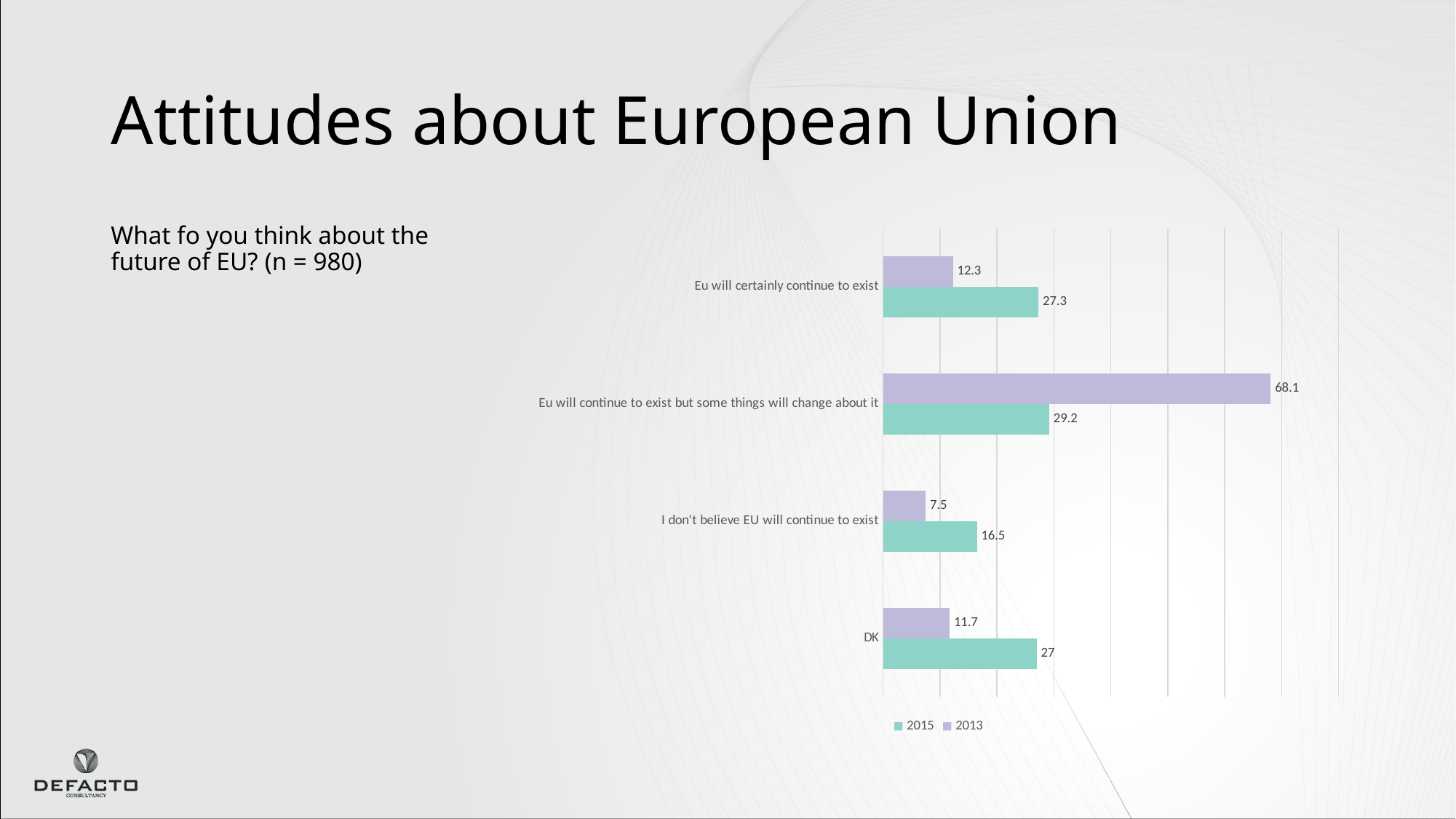
What kind of chart is shown on the slide? Bar chart What is the 2013 value for DK? 11.7 What is the 2013 value for "Eu will continue to exist but some things will change about it"? 68.1 How many categories are shown in the chart? 4 Which category has the highest 2013 value? Eu will continue to exist but some things will change about it Which series is shown in purple according to the legend? 2013 How many series does the legend list? 2 What is the 2015 value for "I don't believe EU will continue to exist"? 16.5 Which category has the lowest 2015 value? I don't believe EU will continue to exist What is the 2015 value for "Eu will certainly continue to exist"? 27.3 Which is larger for DK, the 2015 value or the 2013 value? 2015 What is the difference between the 2013 and 2015 values for "Eu will continue to exist but some things will change about it"? 38.9